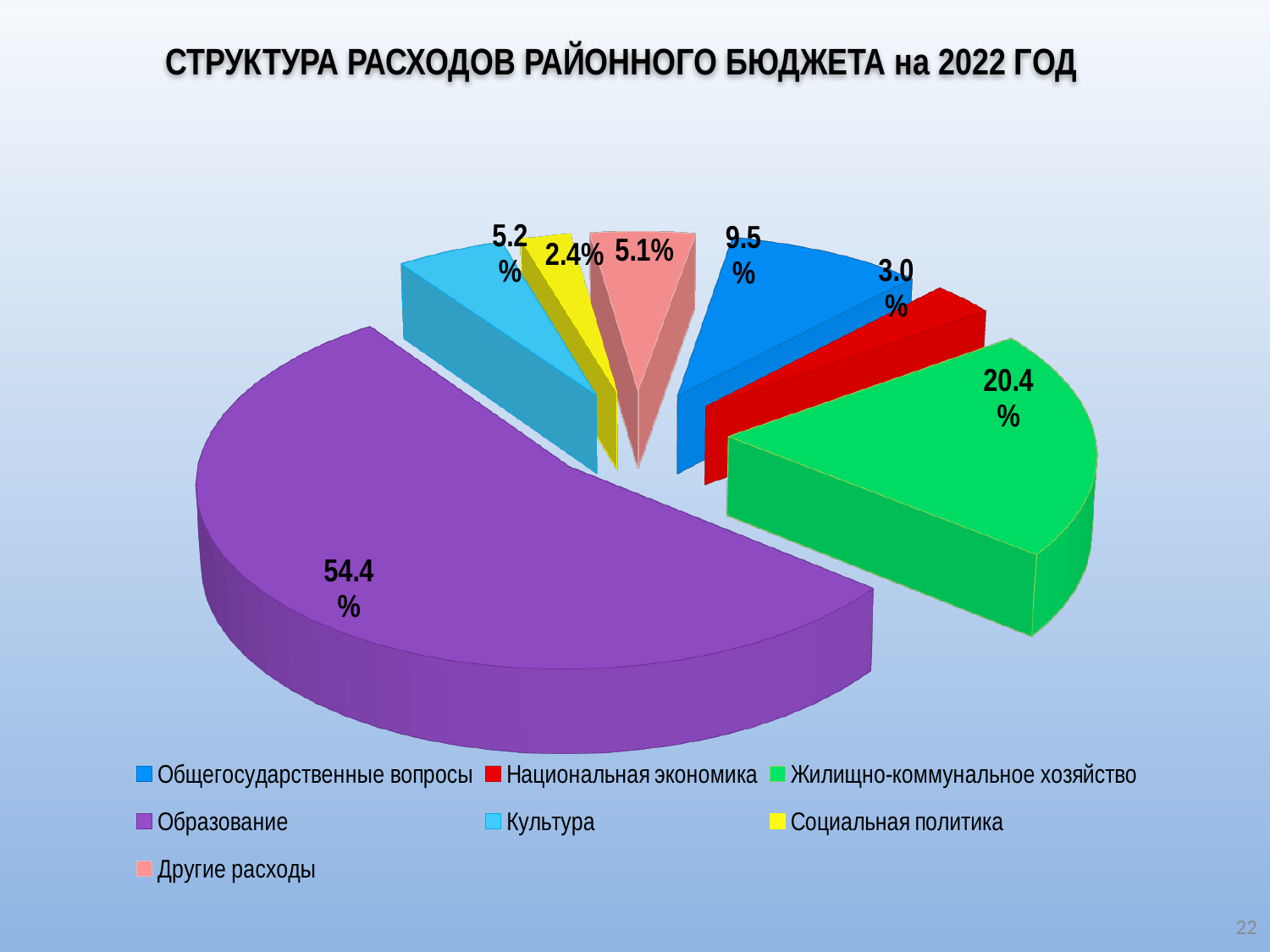
How many categories does the legend list? 7 What is the value shown for Общегосударственные вопросы? 9.5% What is the value shown for Жилищно-коммунальное хозяйство? 20.4% What is the value shown for Социальная политика? 2.4% What is the value shown for Национальная экономика? 3.0% What is the difference between the shares of Образование and Жилищно-коммунальное хозяйство? 34.0% What kind of chart is shown on the slide? pie chart Which category has the largest share of the budget expenditure? Образование What share of the district budget expenditure goes to Образование? 54.4% Which category has the smallest share of the budget expenditure? Социальная политика Which is larger, the share for Культура or the share for Другие расходы? Культура What is the value shown for Культура? 5.2%